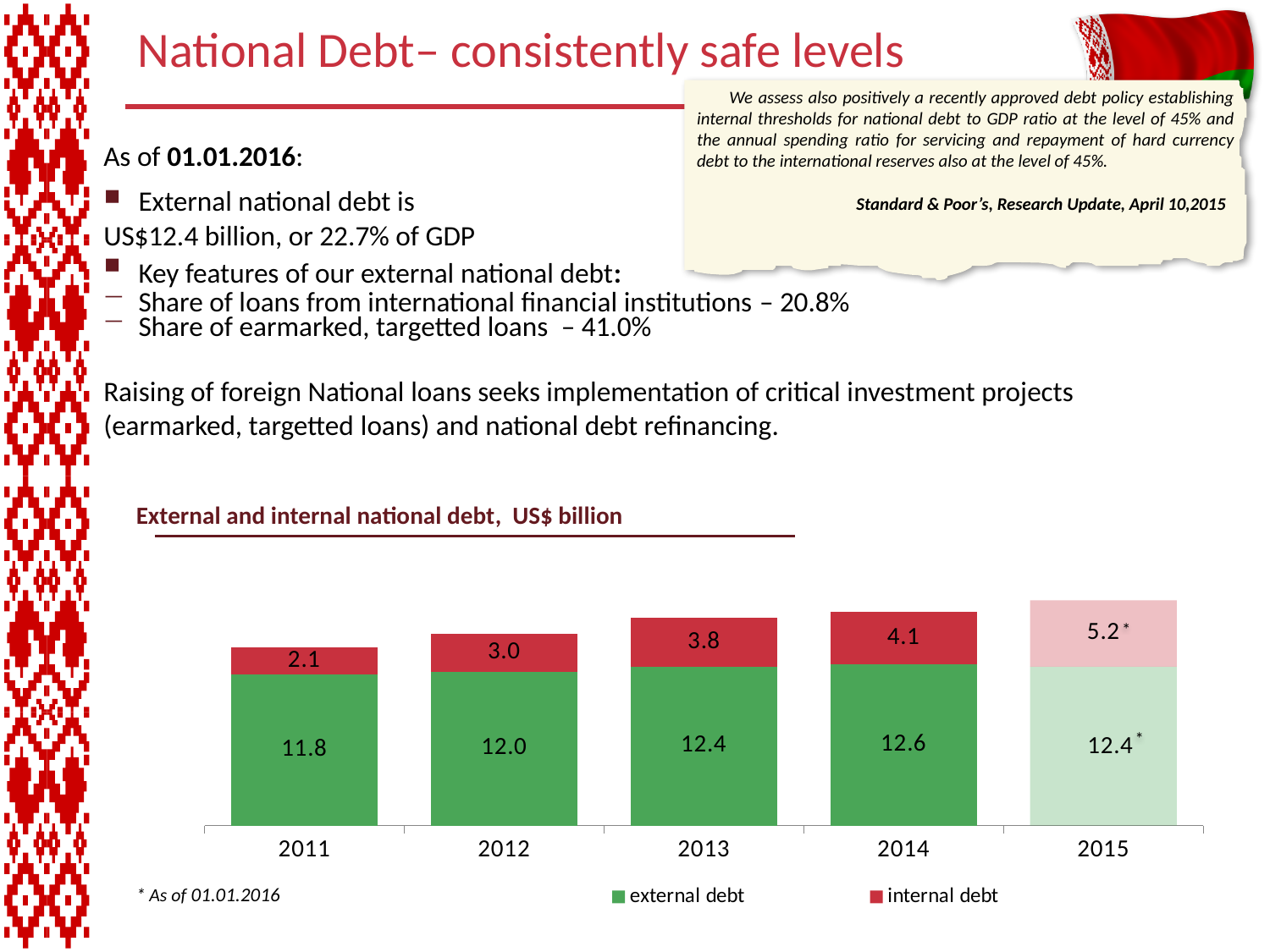
What is the total national debt (external plus internal) for 2015? 17.6 How many years are shown on the x axis of the chart? 5 Which is larger, the external debt in 2014 or in 2012? 2014 What is the internal debt value for 2015? 5.2 What is the internal debt value for 2011? 2.1 What is the difference between the internal debt in 2014 and in 2011? 2.0 Which year has the lowest external debt? 2011 How many series does the chart legend list? 2 Which year has the highest internal debt? 2015 What is the external debt value for 2013? 12.4 What type of chart is used to show external and internal national debt? Stacked bar chart What is the total national debt (external plus internal) for 2012? 15.0